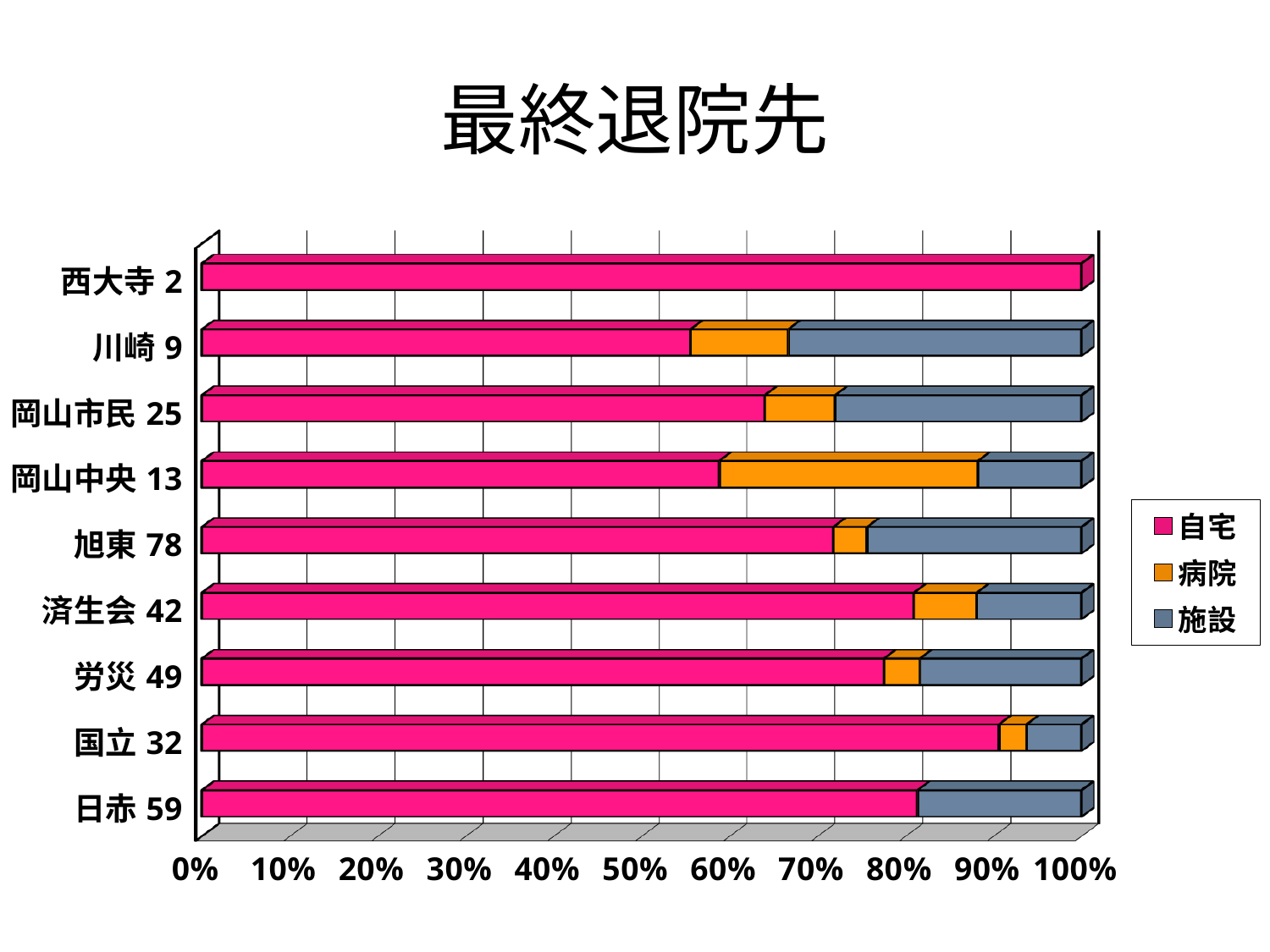
What is the title of the chart? 最終退院先 How many categories (hospitals) are plotted on the chart? 9 What is the total of the stacked bar for 西大寺 2? 100% Which category has the largest 施設 segment? 川崎 9 How many series does the legend list? 3 Is the 自宅 share for 川崎 9 greater or less than 60%? less What are the three series listed in the legend? 自宅, 病院, 施設 What kind of chart is shown on the slide? bar chart Is the 自宅 share for 労災 49 greater or less than 70%? greater Which has a larger 自宅 share, 国立 32 or 労災 49? 国立 32 Which category has the highest share of 自宅? 西大寺 2 Which category has the largest 病院 segment? 岡山中央 13